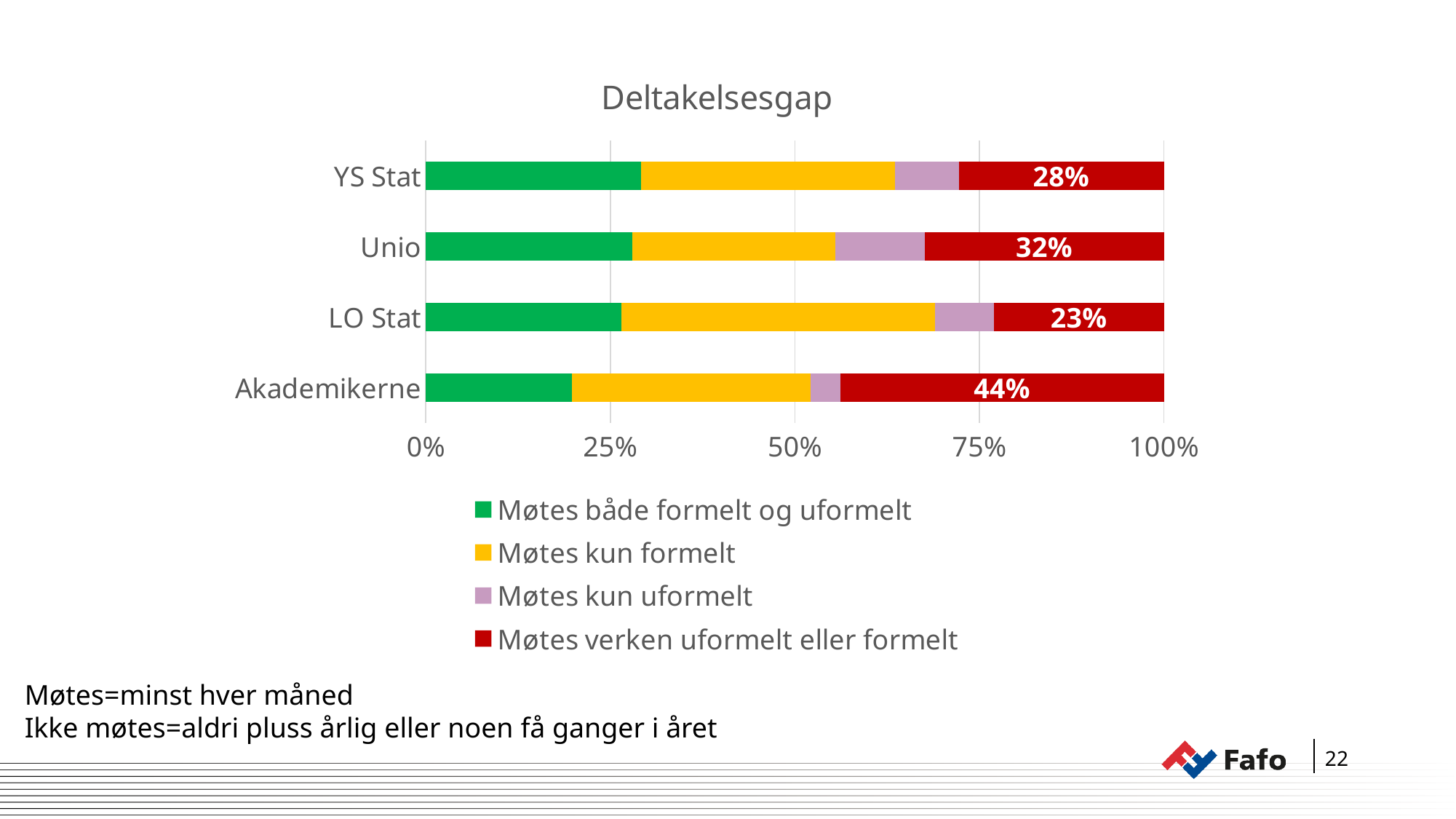
Is the 'Møtes både formelt og uformelt' value for Akademikerne greater or less than 25%? less Which organisation has the lowest share in the 'Møtes verken uformelt eller formelt' category? LO Stat What percentage of Akademikerne respondents fall in the 'Møtes verken uformelt eller formelt' category? 44% What type of chart is shown on the slide? Stacked bar chart Which has a larger 'Møtes verken uformelt eller formelt' share, Unio or YS Stat? Unio Which organisation has the highest share in the 'Møtes verken uformelt eller formelt' category? Akademikerne What is the value of the 'Møtes verken uformelt eller formelt' segment for LO Stat? 23% How many series does the legend list? 4 What is the difference between the 'Møtes verken uformelt eller formelt' values for Akademikerne and LO Stat? 21% What is the value of the 'Møtes verken uformelt eller formelt' segment for YS Stat? 28% How many organisations are shown on the chart? 4 What is the value of the 'Møtes verken uformelt eller formelt' segment for Unio? 32%